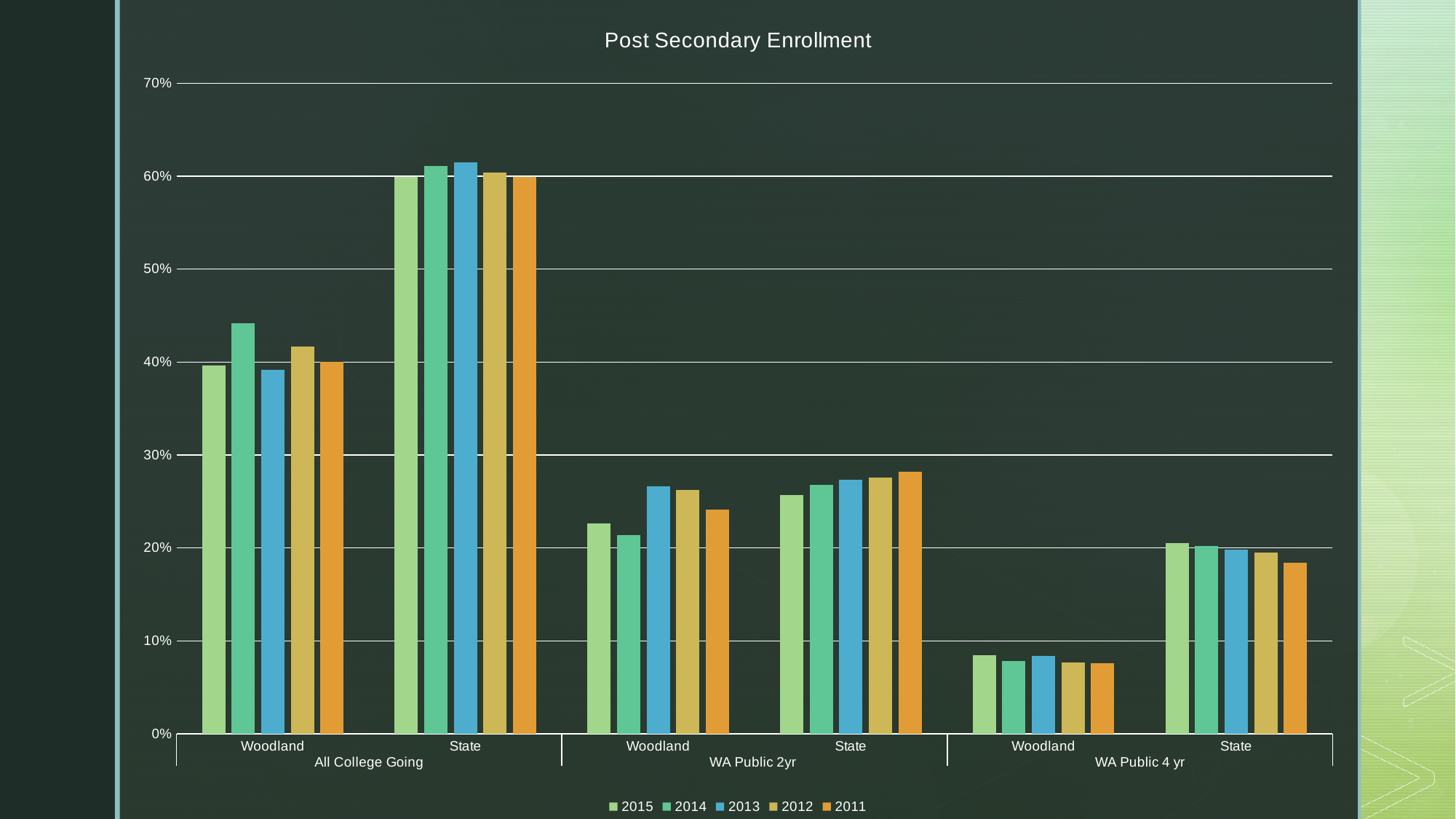
What is the title of the chart? Post Secondary Enrollment How many top-level category groups are shown along the x axis (All College Going, WA Public 2yr, WA Public 4 yr)? 3 Is the 2013 value for State under All College Going greater or less than 60%? greater Is the 2014 value for Woodland under All College Going greater or less than 40%? greater Is the 2011 value for State under WA Public 2yr greater or less than 30%? less Within Woodland under All College Going, which year has the highest bar? 2014 How many series does the legend list? 5 Within Woodland under WA Public 2yr, which year has the lowest bar? 2014 For 2015 under WA Public 4 yr, which is larger: Woodland or State? State What kind of chart is shown on the slide? bar chart Within State under WA Public 4 yr, do the bars rise or fall going left to right from 2015 to 2011? fall